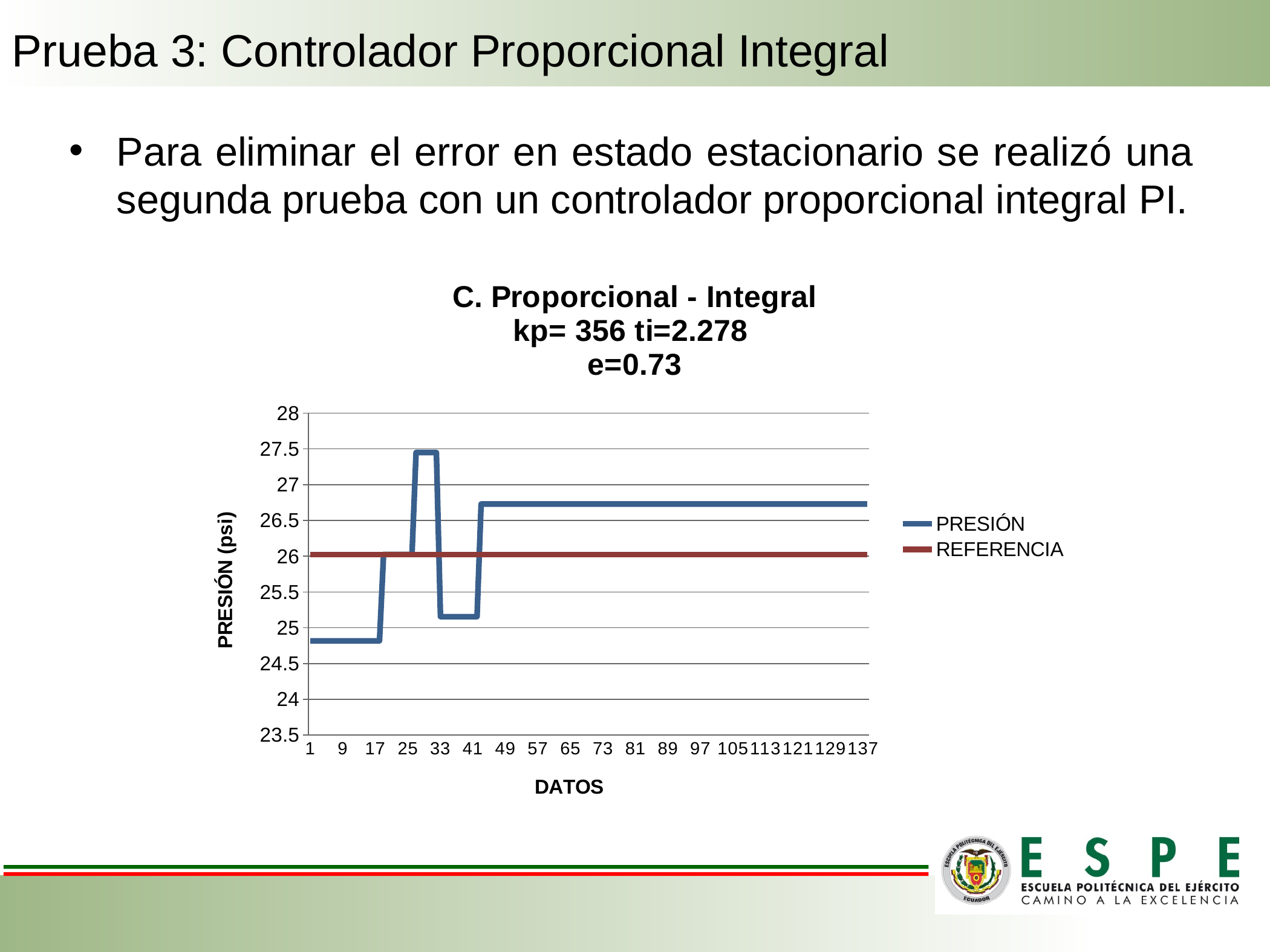
At data point 1, which series has the higher value, PRESIÓN or REFERENCIA? REFERENCIA What is the label of the vertical axis? PRESIÓN (psi) What are the two series named in the legend? PRESIÓN and REFERENCIA Is the PRESIÓN value at data point 1 greater or less than 25? less Is the PRESIÓN value at data point 137 greater or less than 26.5? greater Is the PRESIÓN value at data point 37 greater or less than 25.5? less What kind of chart is shown on the slide? line chart How many series does the legend list? 2 What is the highest tick value shown on the vertical axis? 28 At data point 137, which series has the higher value, PRESIÓN or REFERENCIA? PRESIÓN